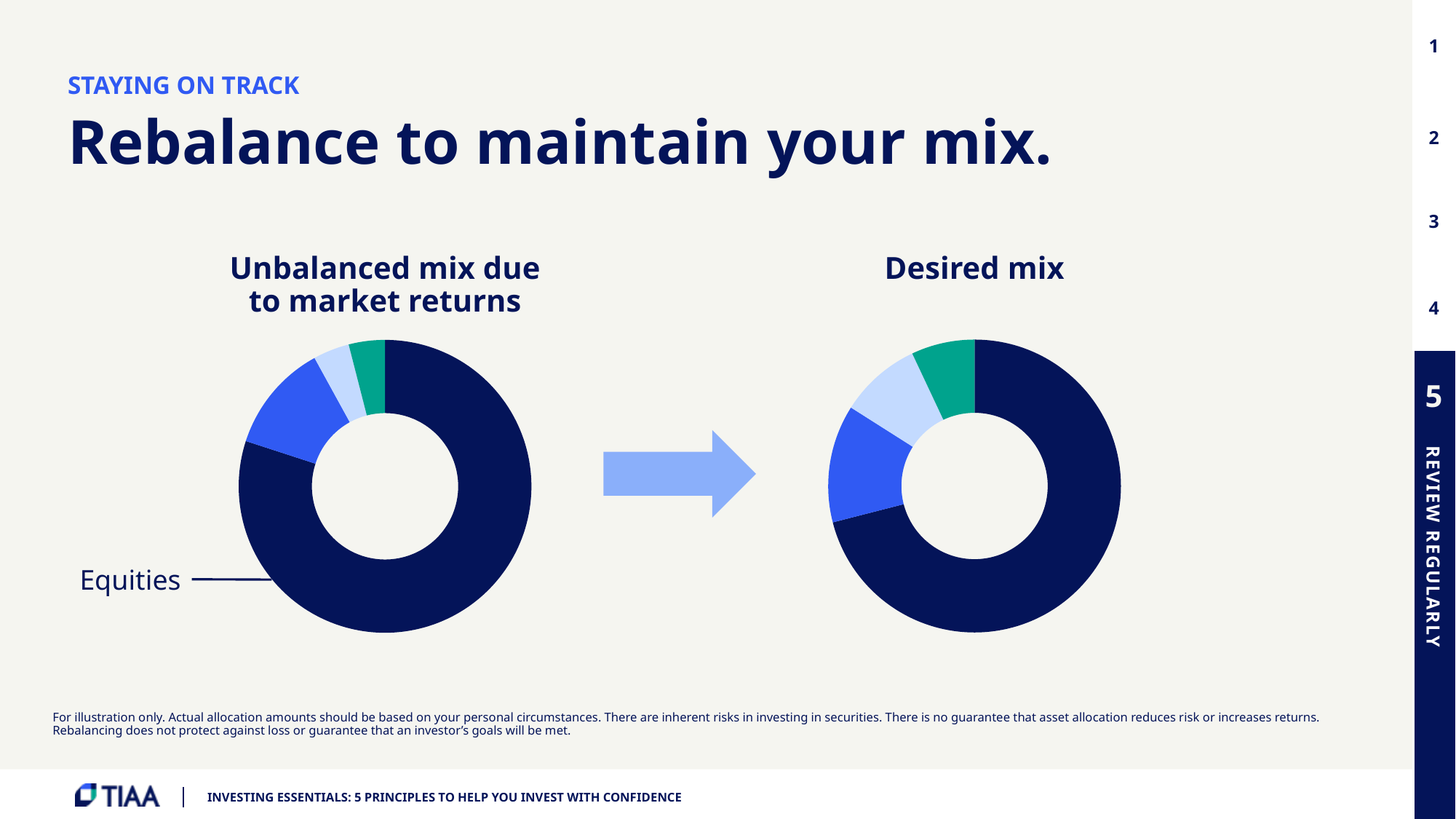
What is the title of the chart on the right side of the slide? Desired mix How many slices does the "Desired mix" chart have? 4 In the "Unbalanced mix due to market returns" chart, which labeled slice is the largest? Equities Which slice is labeled on the "Unbalanced mix due to market returns" chart? Equities Is the Equities slice in the "Unbalanced mix due to market returns" chart larger or smaller than half of the chart? larger How many charts are shown on the slide? 2 What kind of chart is used for the "Unbalanced mix due to market returns" chart? Pie chart (donut) What kind of chart is used for the "Desired mix" chart? Pie chart (donut) How many slices does the "Unbalanced mix due to market returns" chart have? 4 Is the dark navy slice larger in the "Unbalanced mix due to market returns" chart or in the "Desired mix" chart? Unbalanced mix due to market returns